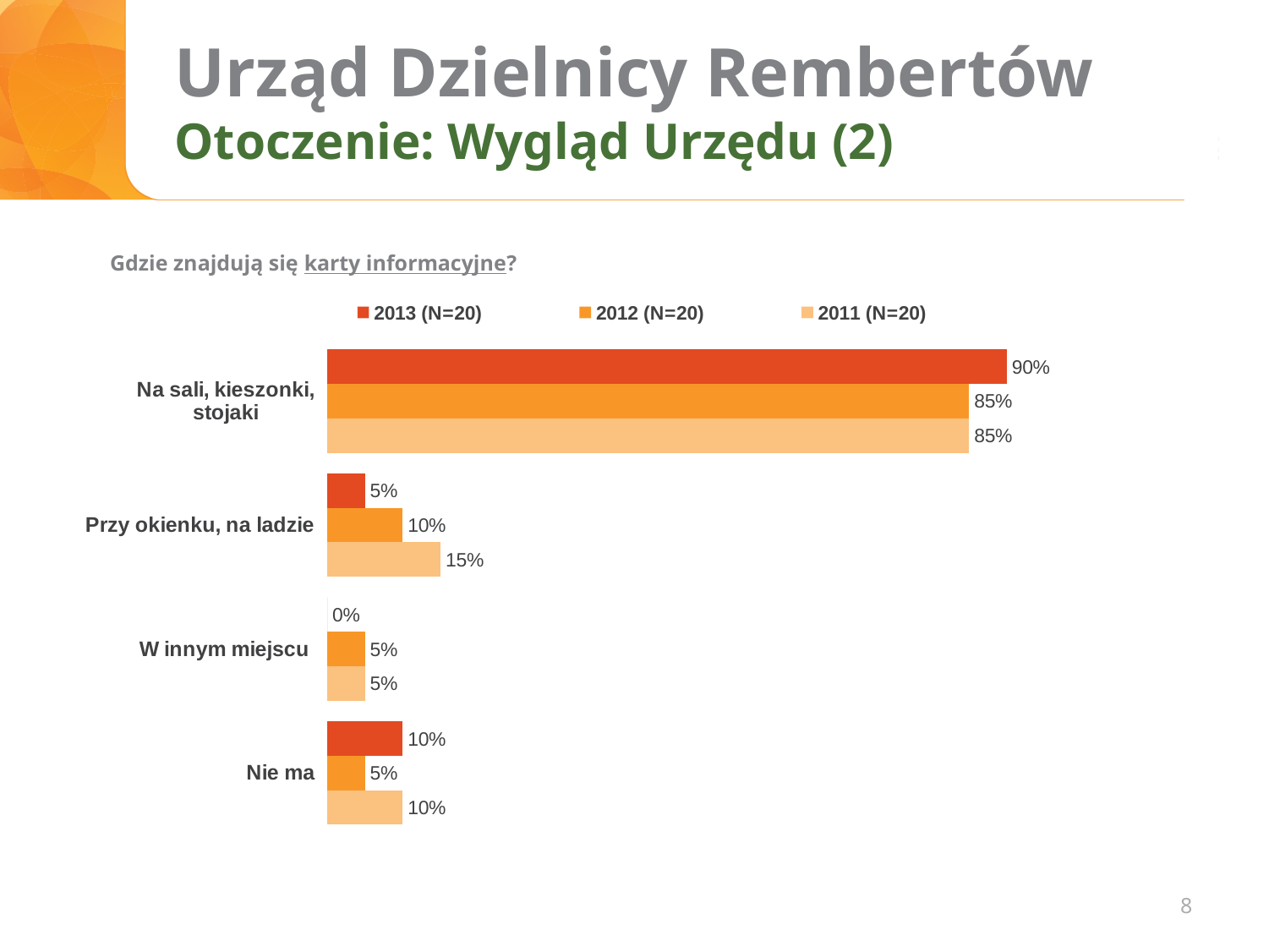
What is the value for "Nie ma" in the 2012 (N=20) series? 5% What is the value for "Na sali, kieszonki, stojaki" in the 2013 (N=20) series? 90% Which category has the highest value in the 2013 (N=20) series? Na sali, kieszonki, stojaki What kind of chart is shown on the slide? Bar chart Which category has the lowest value in the 2013 (N=20) series? W innym miejscu Which is larger for "Nie ma": the 2013 (N=20) value or the 2012 (N=20) value? 2013 (N=20) How many series does the legend list? 3 What is the difference between the 2011 (N=20) and 2013 (N=20) values for "Przy okienku, na ladzie"? 10% How many categories are shown on the chart? 4 What is the value for "W innym miejscu" in the 2013 (N=20) series? 0% What is the difference between the 2013 (N=20) and 2011 (N=20) values for "Na sali, kieszonki, stojaki"? 5% What is the value for "Przy okienku, na ladzie" in the 2011 (N=20) series? 15%